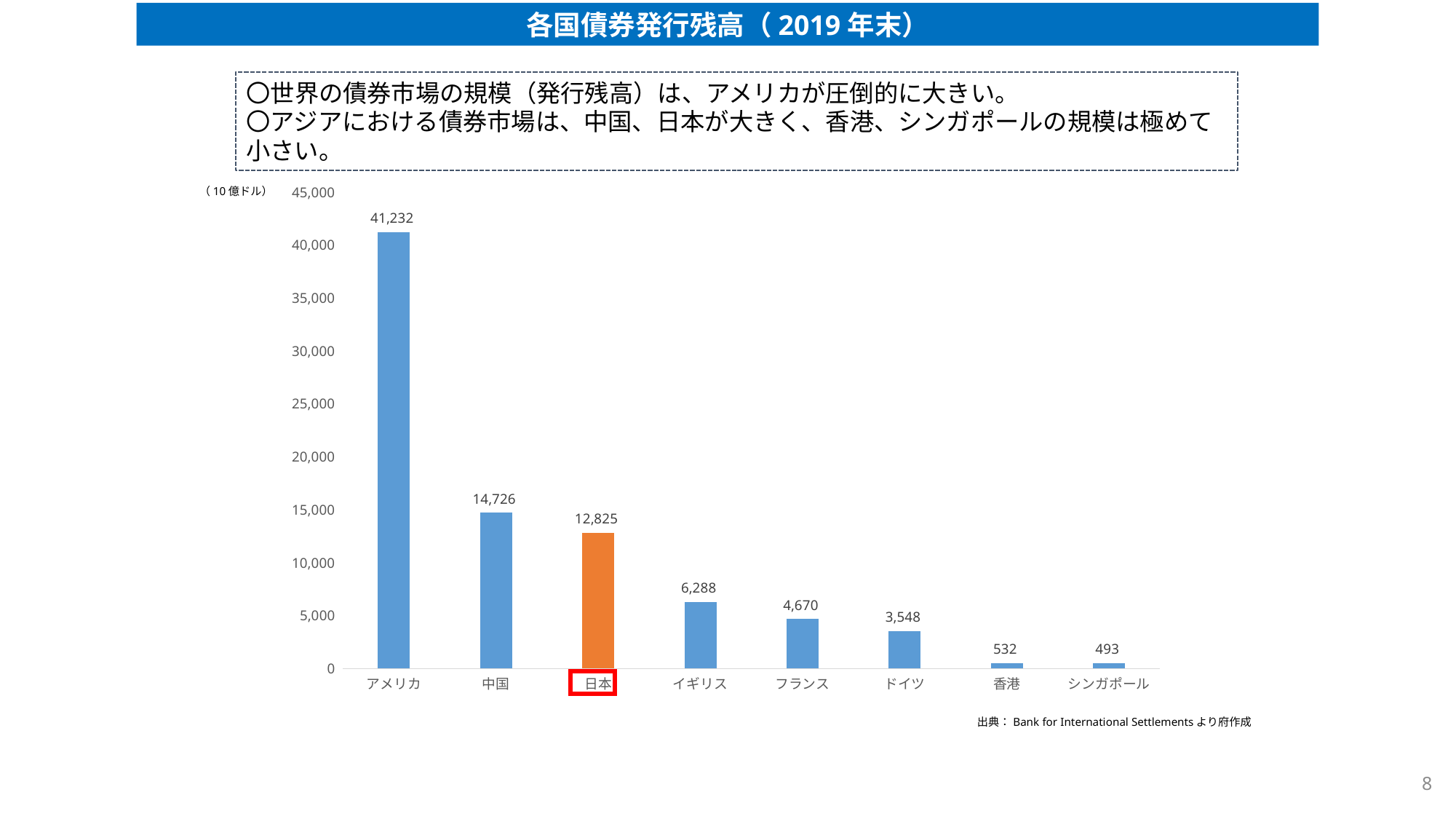
Which is larger, the value for 香港 or the value for ドイツ? ドイツ Which country has the highest value? アメリカ Which country's bar is coloured orange? 日本 What is the difference between the values for 中国 and 日本? 1,901 How many countries are shown on the chart? 8 What is the value for ドイツ? 3,548 What is the value for 日本? 12,825 Is the value for 中国 greater or less than 10,000? greater What kind of chart is shown on the slide? bar chart What is the difference between the values for イギリス and フランス? 1,618 What is the value for アメリカ? 41,232 Which country has the lowest value? シンガポール